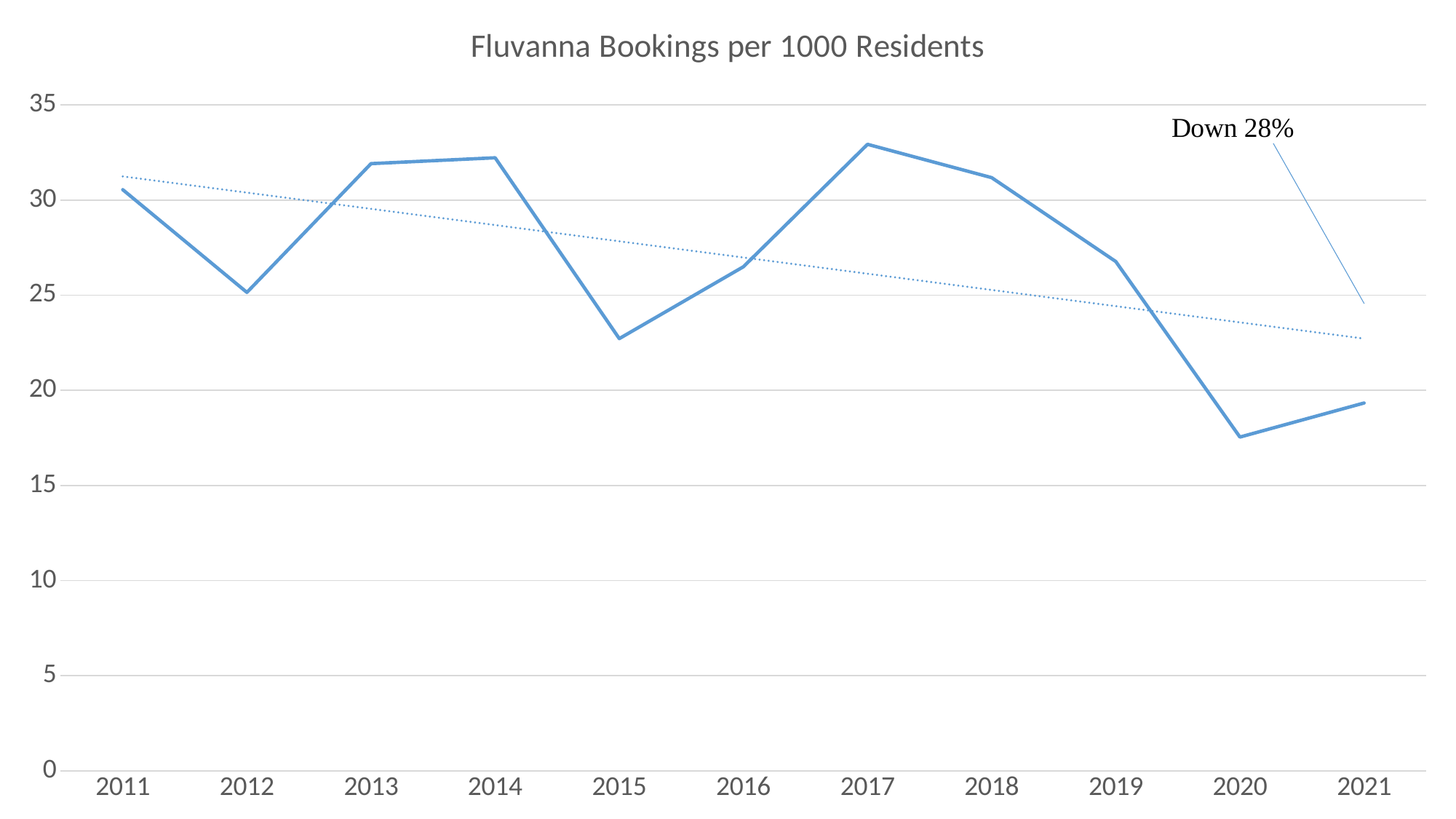
Is the value for 2019 greater or less than 25? greater Is the value for 2015 greater or less than 20? greater Which year has the highest bookings per 1000 residents? 2017 What is the title of the chart? Fluvanna Bookings per 1000 Residents Which year has the lowest bookings per 1000 residents? 2020 Does the dotted trend line rise or fall from 2011 to 2021? fall Which year has the higher value, 2015 or 2016? 2016 What kind of chart is shown on the slide? line chart How many years are plotted along the x axis? 11 Is the value for 2020 greater or less than 20? less What does the annotation near the right side of the chart say? Down 28%